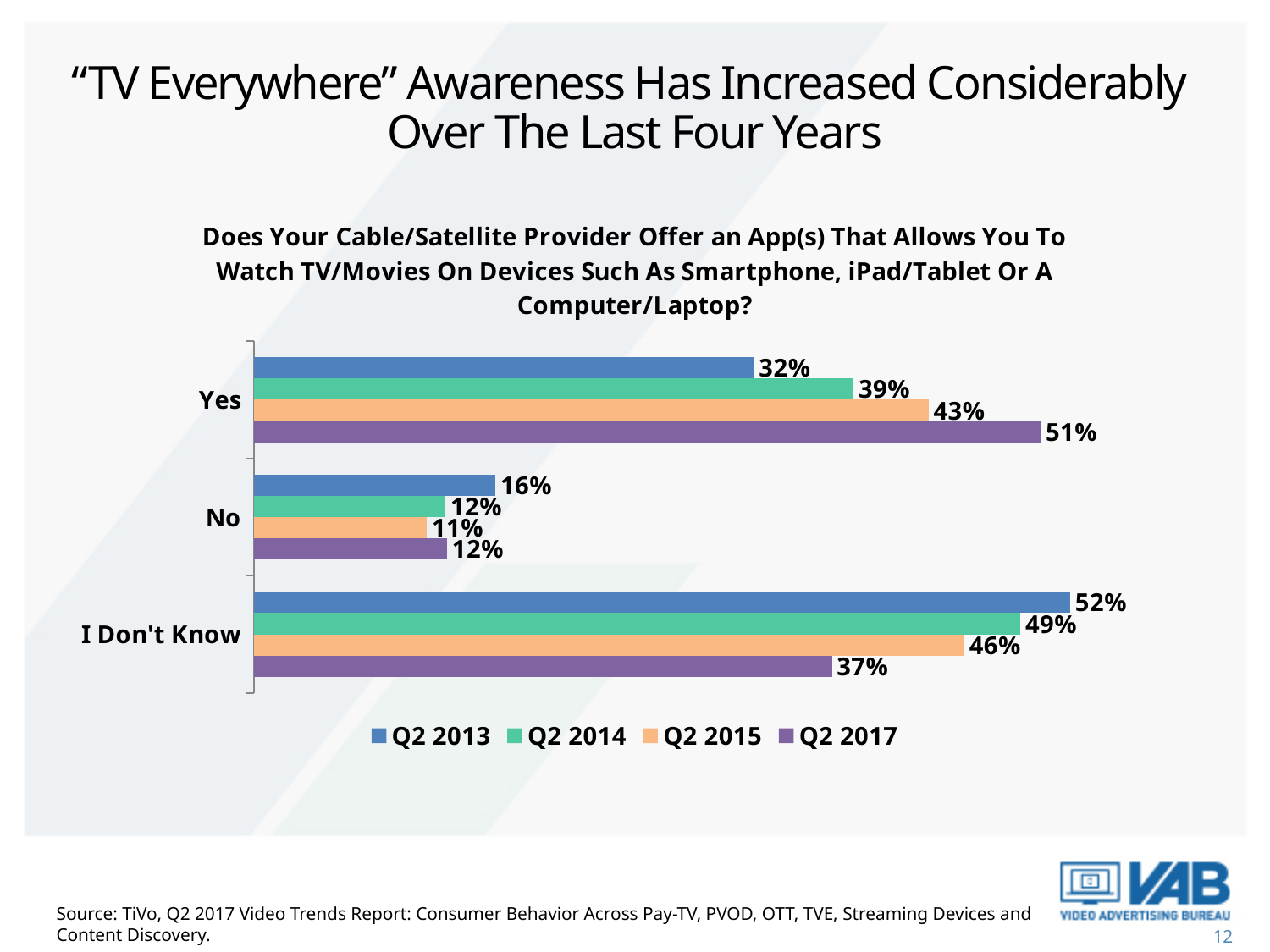
Which year has the lowest value for "I Don't Know"? Q2 2017 What is the value for "I Don't Know" in Q2 2013? 52% What kind of chart is shown on the slide? Bar chart What is the value for "Yes" in Q2 2014? 39% How many series does the legend list? 4 What is the value for "Yes" in Q2 2017? 51% How many response categories are shown on the chart? 3 What is the value for "No" in Q2 2015? 11% Which is larger: the "I Don't Know" value for Q2 2015 or the "Yes" value for Q2 2015? I Don't Know (46%) Does the "Yes" value rise or fall from Q2 2013 to Q2 2017? Rise Which year has the highest value for "Yes"? Q2 2017 What is the difference between the "Yes" values for Q2 2017 and Q2 2013? 19%